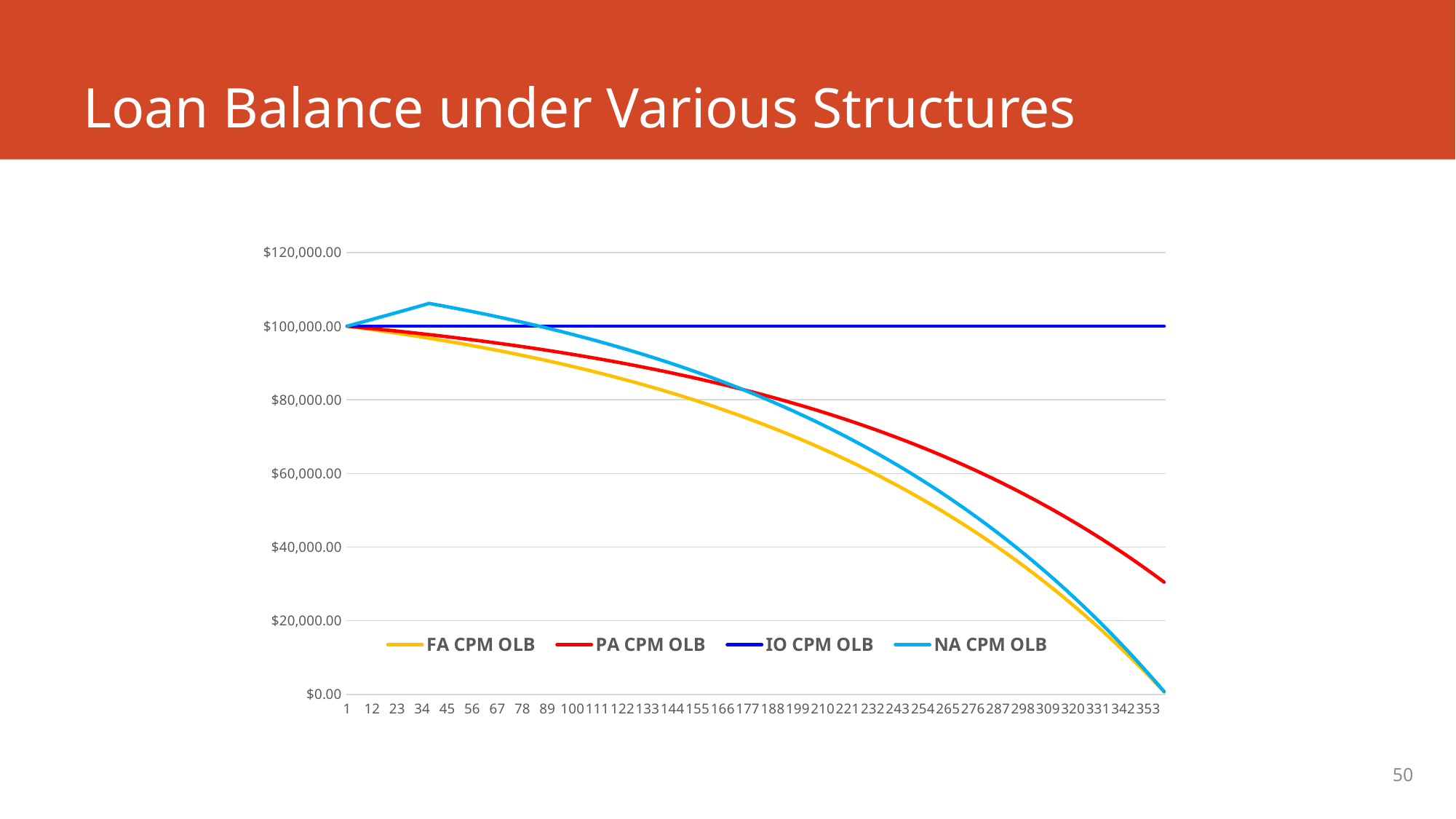
At period 353, which is larger: PA CPM OLB or FA CPM OLB? PA CPM OLB Is the value of PA CPM OLB at period 353 greater or less than $40,000.00? less What is the value of the PA CPM OLB series at period 1? $100,000.00 What kind of chart is shown on the slide? line chart Does the FA CPM OLB line rise or fall along the x axis? fall Is the peak value of NA CPM OLB greater or less than $100,000.00? greater What is the constant value of the IO CPM OLB line? $100,000.00 How many series does the legend list? 4 Does the IO CPM OLB line rise, fall, or stay flat along the x axis? stays flat Which series has the highest value at period 353? IO CPM OLB What is the title of the slide containing the chart? Loan Balance under Various Structures Which series is drawn in red? PA CPM OLB